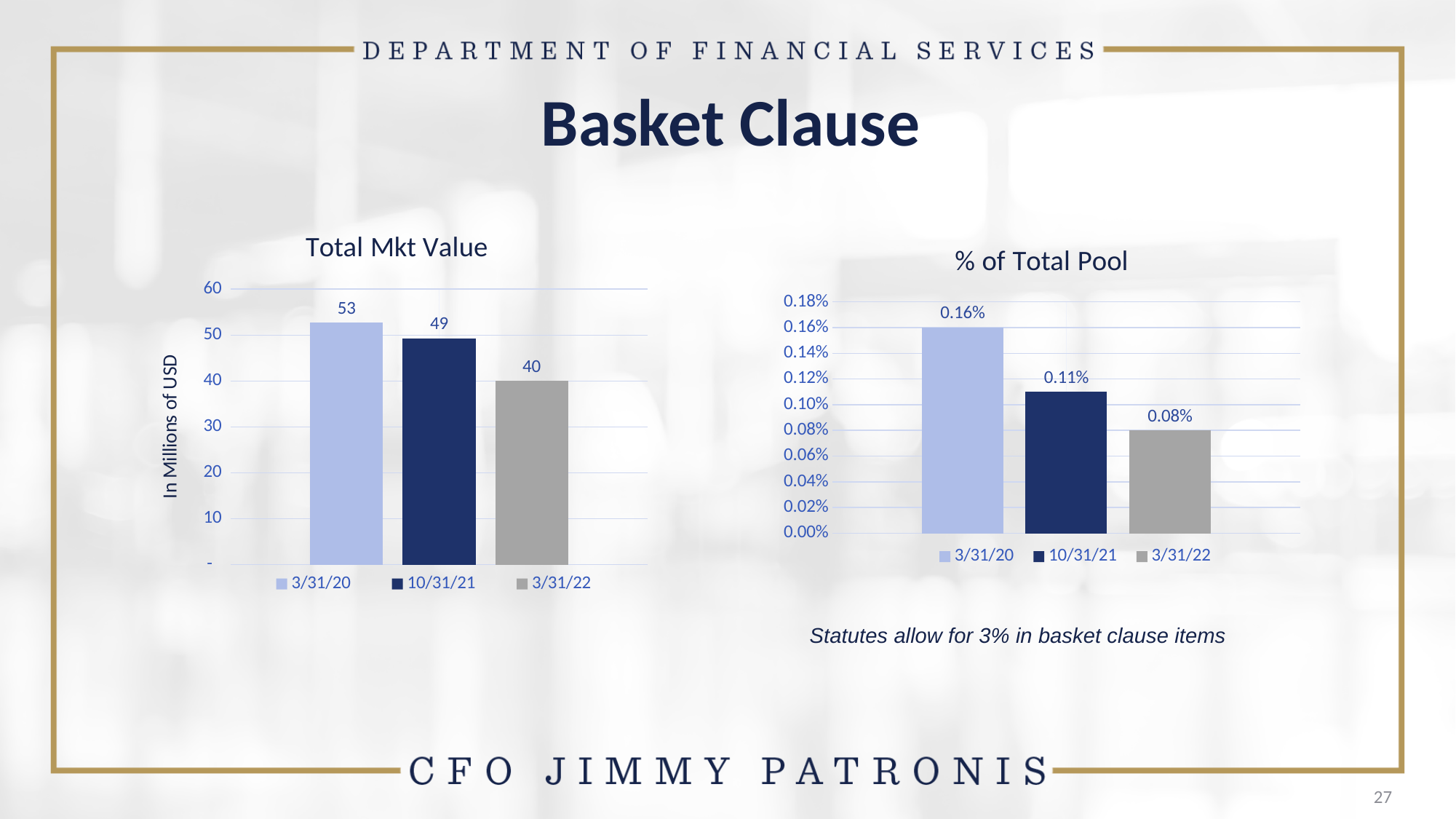
How many bars are plotted in the % of Total Pool chart? 3 In the Total Mkt Value chart, which is larger, the value for 10/31/21 or the value for 3/31/22? 10/31/21 In the % of Total Pool chart, which date has the lowest value? 3/31/22 In the % of Total Pool chart, what is the value for 10/31/21? 0.11% In the % of Total Pool chart, what is the value for 3/31/22? 0.08% In the % of Total Pool chart, what is the difference between the values for 3/31/20 and 10/31/21? 0.05% In the Total Mkt Value chart, what is the value for 3/31/22? 40 In the Total Mkt Value chart, which date has the highest value? 3/31/20 In the Total Mkt Value chart, what is the value for 3/31/20? 53 Do the values in the Total Mkt Value chart rise or fall from left to right? fall What kind of chart is the % of Total Pool chart? bar chart In the Total Mkt Value chart, what is the difference between the values for 3/31/20 and 3/31/22? 13